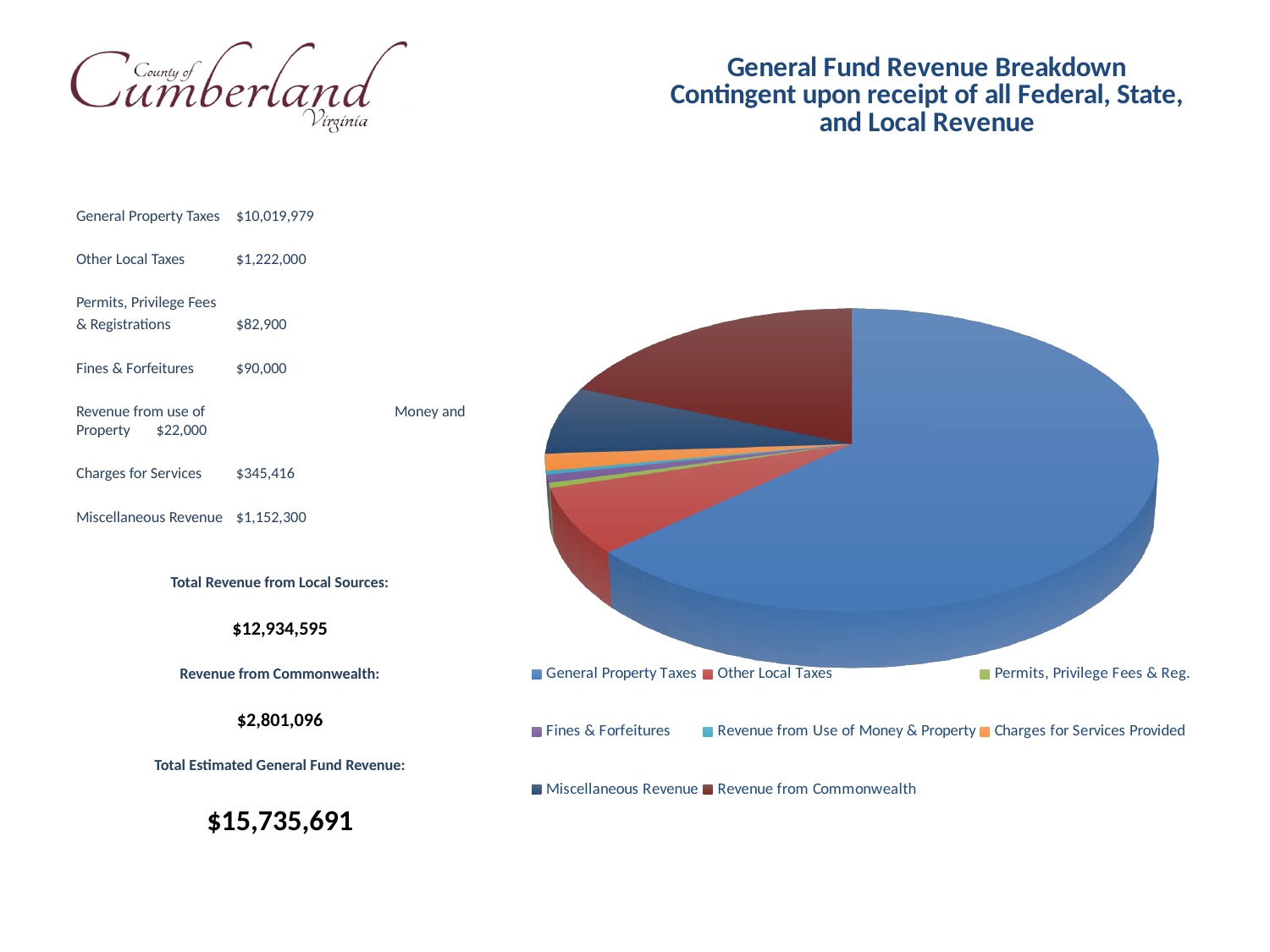
What is the value for Revenue from Commonwealth? $2,801,096 What colour is the General Property Taxes slice in the pie chart? Blue Which category has the largest slice of the pie chart? General Property Taxes What is the Total Estimated General Fund Revenue shown on the slide? $15,735,691 What kind of chart is shown on the slide? Pie chart What is the difference between Other Local Taxes and Miscellaneous Revenue? $69,700 What is the value for General Property Taxes? $10,019,979 Which is larger, Other Local Taxes or Revenue from Commonwealth? Revenue from Commonwealth What is the value for Charges for Services? $345,416 What is the difference between Charges for Services and Fines & Forfeitures? $255,416 What is the value for Miscellaneous Revenue? $1,152,300 How many categories does the pie chart's legend list? 8